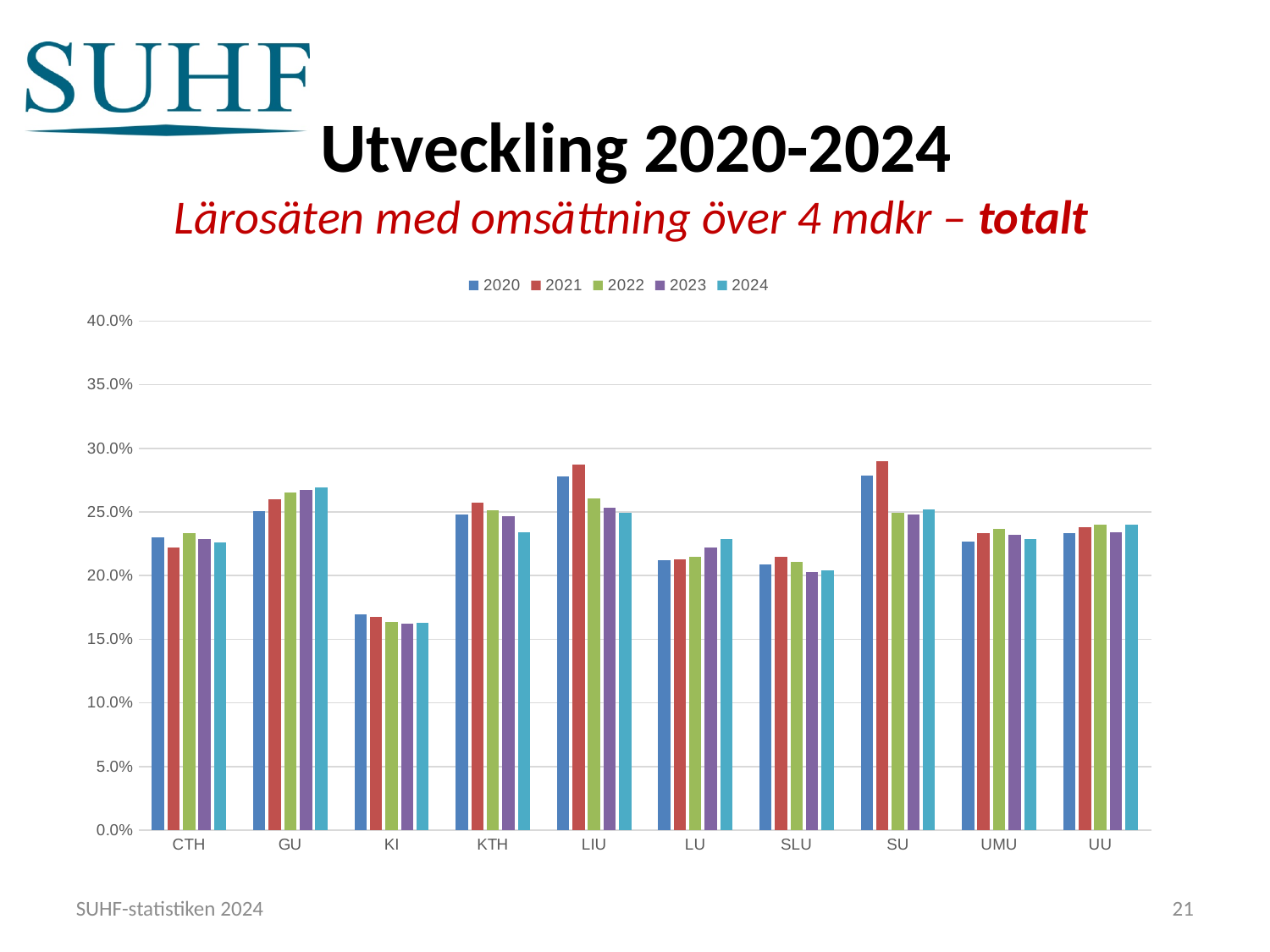
Is the value for GU in 2024 greater or less than 25.0%? greater How many categories (lärosäten) are shown on the x axis? 10 For SU, which year has the highest value? 2021 What kind of chart is shown on the slide? bar chart How many series does the legend list? 5 Is the value for KTH in 2024 greater or less than 20.0%? greater Which colour represents the 2021 series in the legend? red Which category has the lowest values overall? KI Which is larger, the 2020 value for SU or the 2020 value for LU? SU Is the value for LU in 2020 greater or less than 25.0%? less Do the values for GU rise or fall from 2020 to 2024? rise